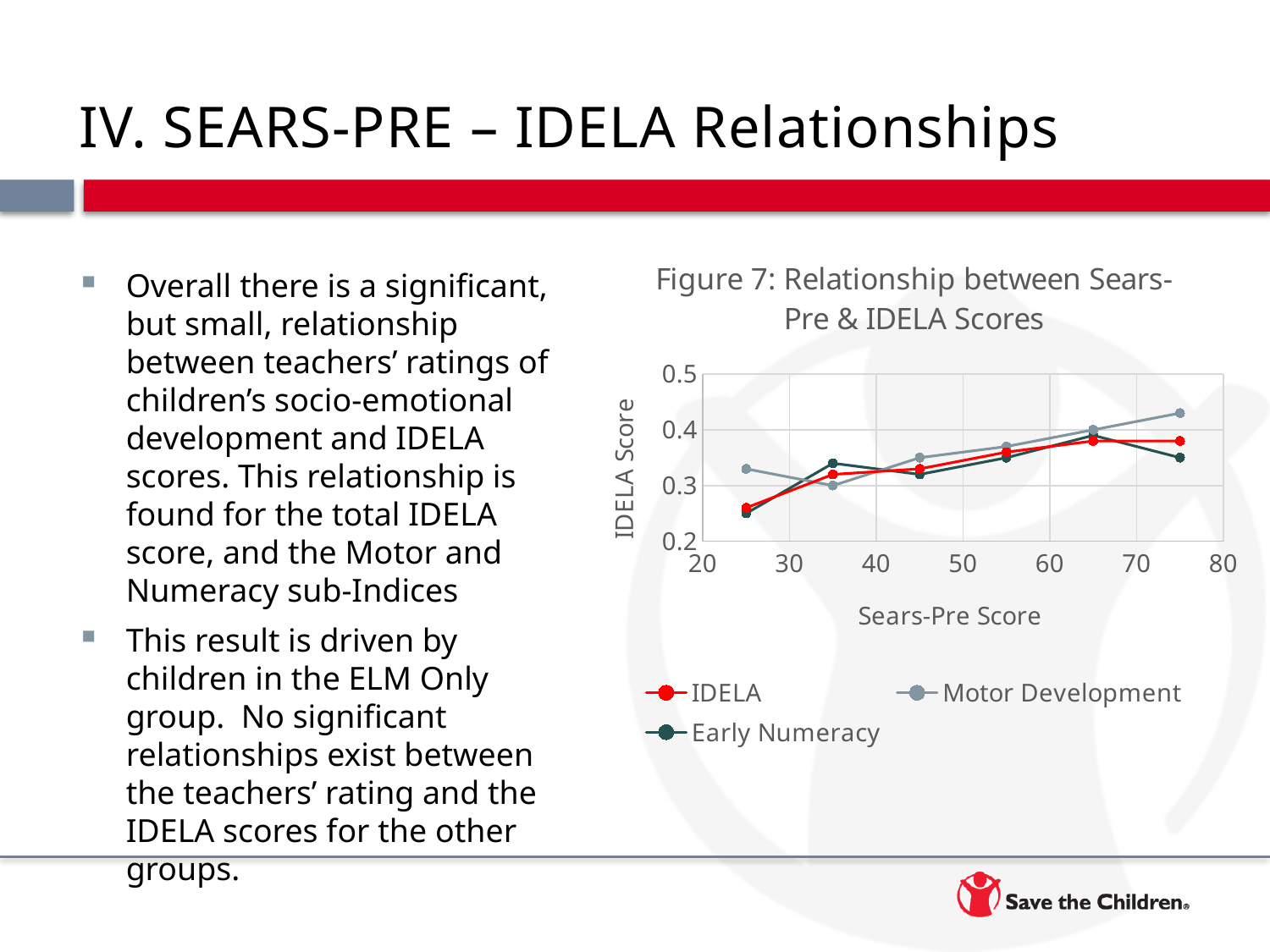
How many data points are plotted for the IDELA series? 6 What is the title of the chart? Figure 7: Relationship between Sears-Pre & IDELA Scores At a Sears-Pre Score of 25, which series has the higher value: Motor Development or IDELA? Motor Development What is the label of the chart's x axis? Sears-Pre Score What kind of chart is shown on the slide? Line chart Is the Motor Development value at a Sears-Pre Score of 75 greater or less than 0.4? greater Is the IDELA value at a Sears-Pre Score of 25 greater or less than 0.3? less Do the Motor Development values generally rise or fall as the Sears-Pre Score increases? Rise At a Sears-Pre Score of 75, which series has the higher value: Motor Development or Early Numeracy? Motor Development Is the Early Numeracy value at a Sears-Pre Score of 75 greater or less than 0.4? less How many series does the chart's legend list? 3